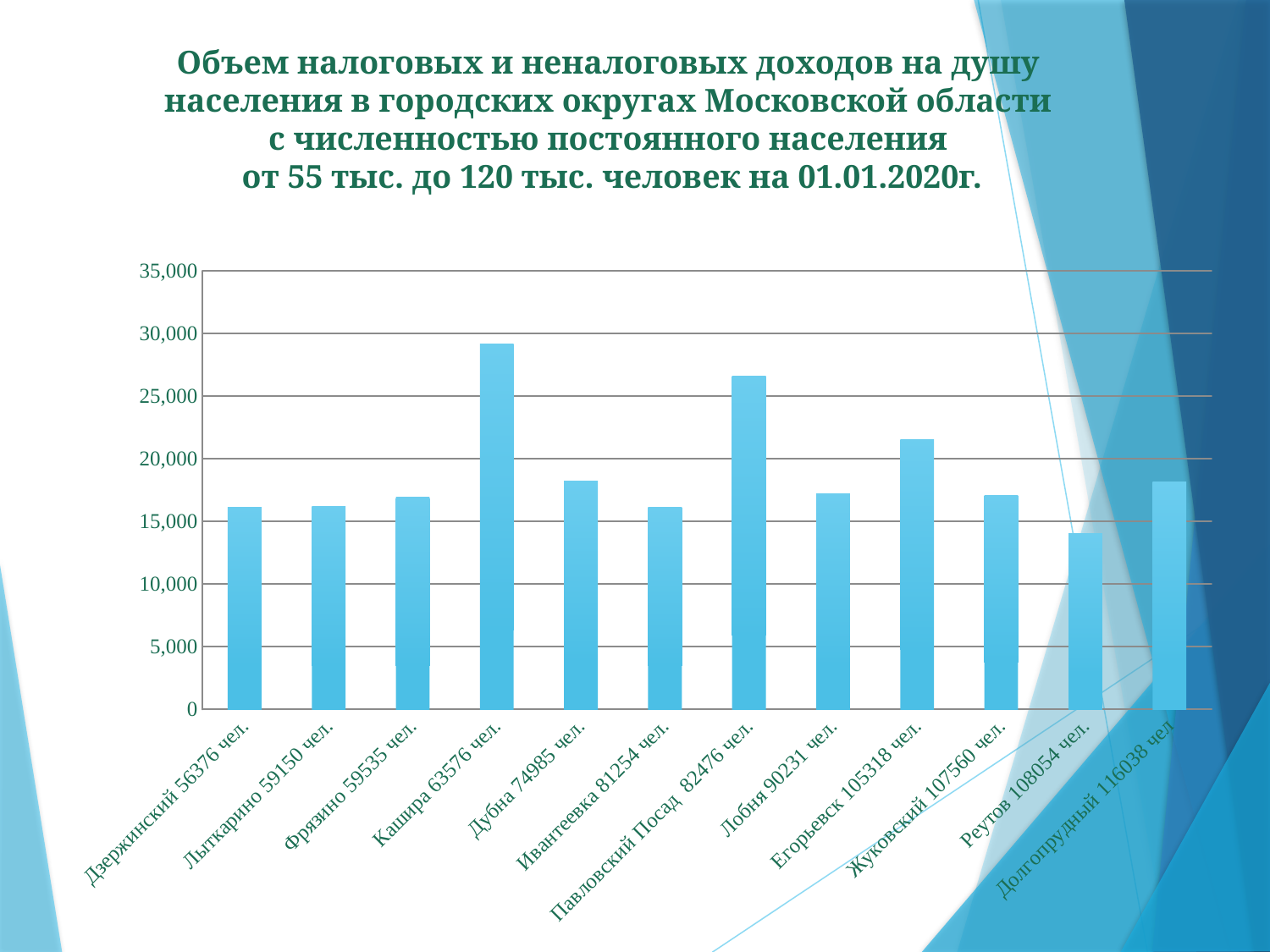
Which city district has the lowest value on the chart? Реутов 108054 чел. Is the value for Егорьевск 105318 чел. greater or less than 20,000? greater What kind of chart is shown on the slide? bar chart How many city districts (categories) are plotted on the chart? 12 Which city district has the highest value on the chart? Кашира 63576 чел. Is the value for Фрязино 59535 чел. greater or less than 20,000? less Is the value for Павловский Посад 82476 чел. greater or less than 25,000? greater What is the maximum value shown on the vertical axis of the chart? 35,000 Which is larger, the value for Кашира 63576 чел. or the value for Павловский Посад 82476 чел.? Кашира 63576 чел. Which is larger, the value for Егорьевск 105318 чел. or the value for Лобня 90231 чел.? Егорьевск 105318 чел.